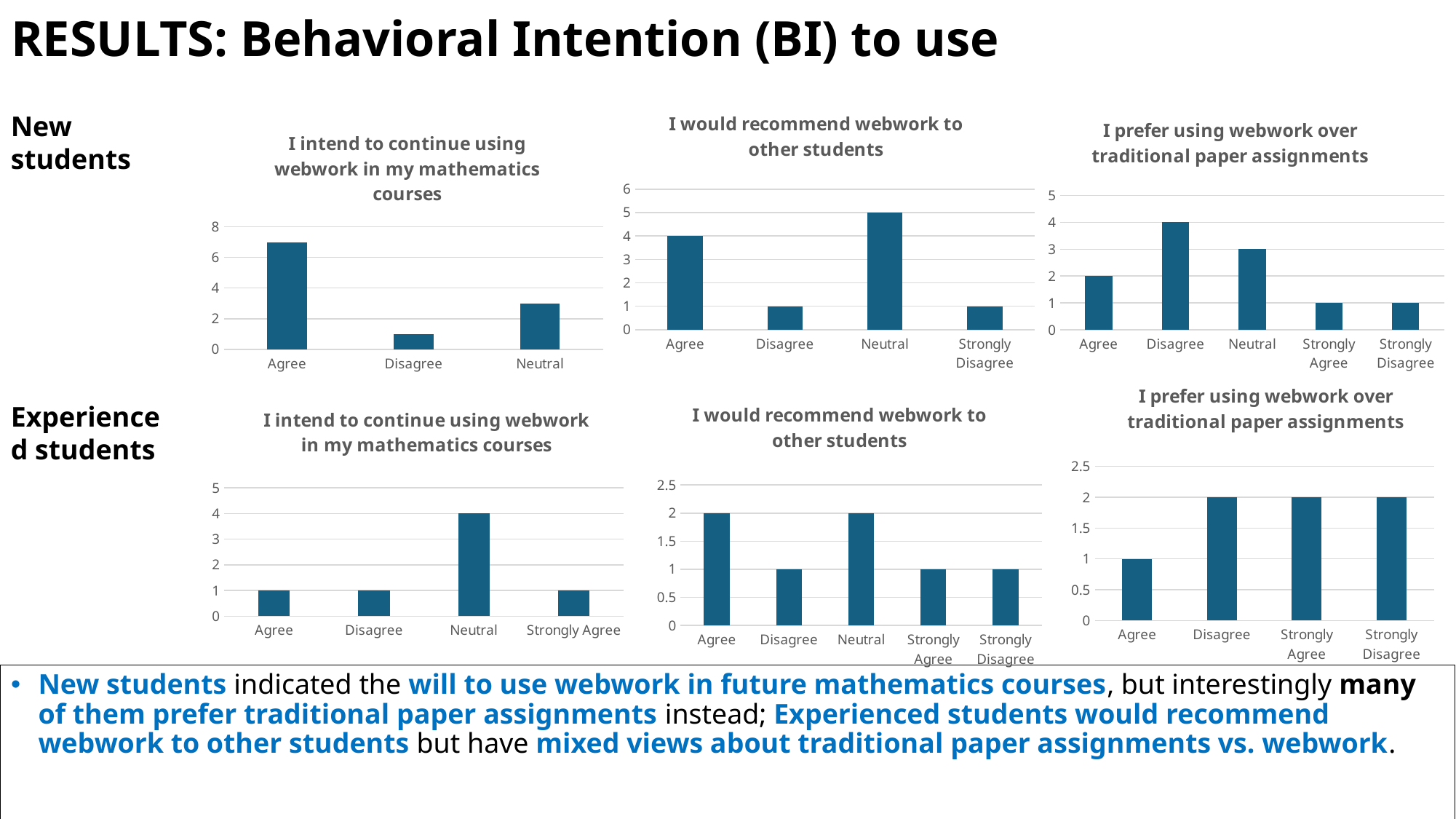
What type of chart is used for the New students 'I prefer using webwork over traditional paper assignments' chart? bar chart In the New students chart 'I intend to continue using webwork in my mathematics courses', is the value for Agree greater or less than 6? greater In the New students chart 'I prefer using webwork over traditional paper assignments', which category has the highest value? Disagree In the Experienced students chart 'I would recommend webwork to other students', which is larger: Agree or Disagree? Agree In the Experienced students chart 'I intend to continue using webwork in my mathematics courses', what is the value for Neutral? 4 In the New students chart 'I would recommend webwork to other students', what is the value for Neutral? 5 In the New students chart 'I prefer using webwork over traditional paper assignments', what is the difference between Disagree and Agree? 2 In the Experienced students chart 'I prefer using webwork over traditional paper assignments', which category has the lowest value? Agree In the Experienced students chart 'I intend to continue using webwork in my mathematics courses', which category has the highest value? Neutral In the Experienced students chart 'I would recommend webwork to other students', how many categories are shown on the x axis? 5 In the New students chart 'I would recommend webwork to other students', what is the value for Agree? 4 In the New students chart 'I intend to continue using webwork in my mathematics courses', how many categories are shown on the x axis? 3